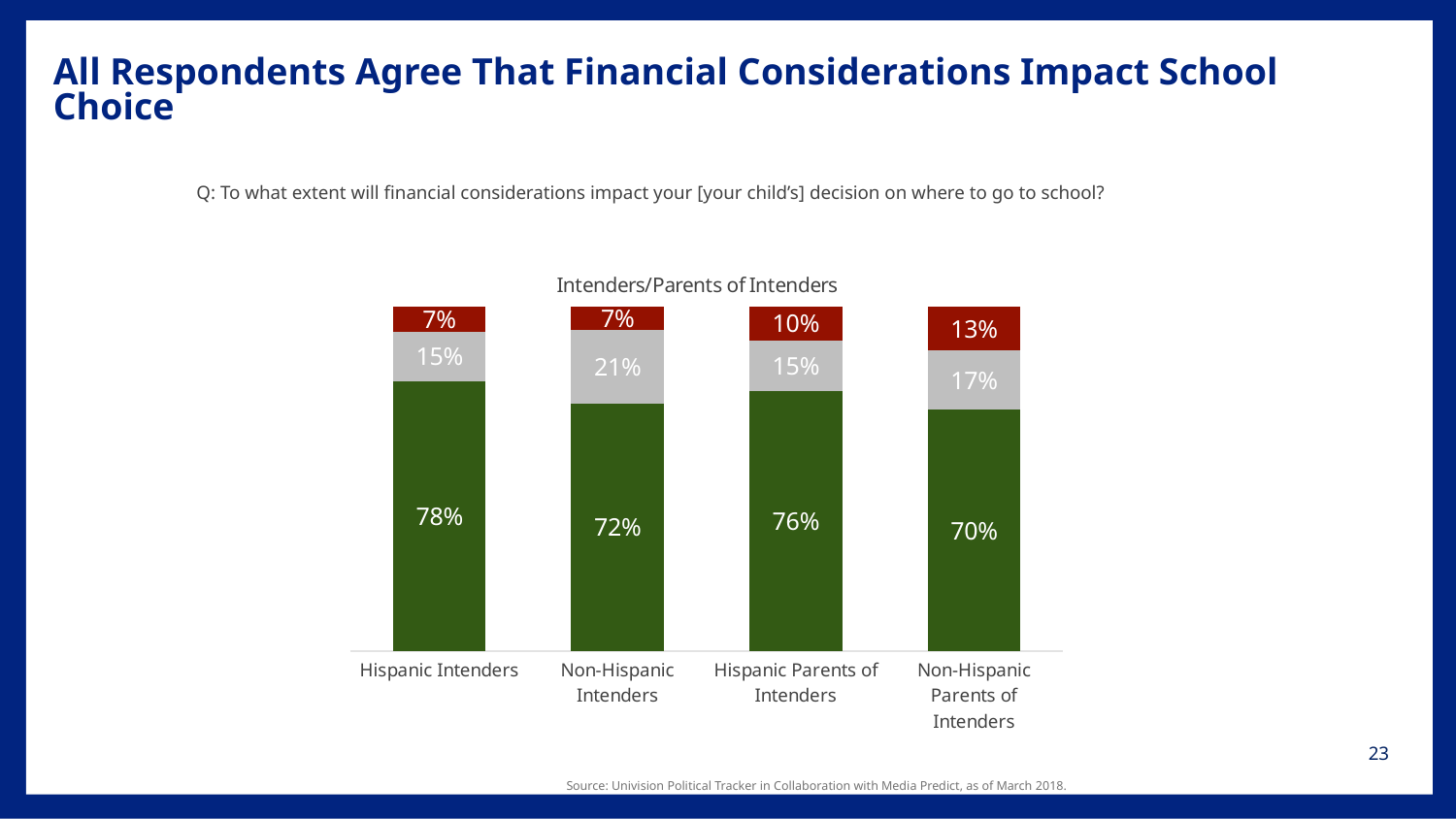
What is the value of the gray (middle) segment for Non-Hispanic Intenders? 21% What is the difference between the green segment values for Hispanic Intenders and Non-Hispanic Parents of Intenders? 8% How many segments make up each stacked bar? 3 Which category has the lowest value in the green segment? Non-Hispanic Parents of Intenders Is the red (top) segment larger for Hispanic Parents of Intenders or for Non-Hispanic Parents of Intenders? Non-Hispanic Parents of Intenders What is the total of the stacked bar for Non-Hispanic Intenders? 100% What is the value of the green segment for Hispanic Intenders? 78% What is the value of the red (top) segment for Non-Hispanic Parents of Intenders? 13% How many categories are shown on the x axis? 4 Which category has the highest value in the green segment? Hispanic Intenders What is the title of the chart? Intenders/Parents of Intenders What type of chart is shown on the slide? Stacked bar chart